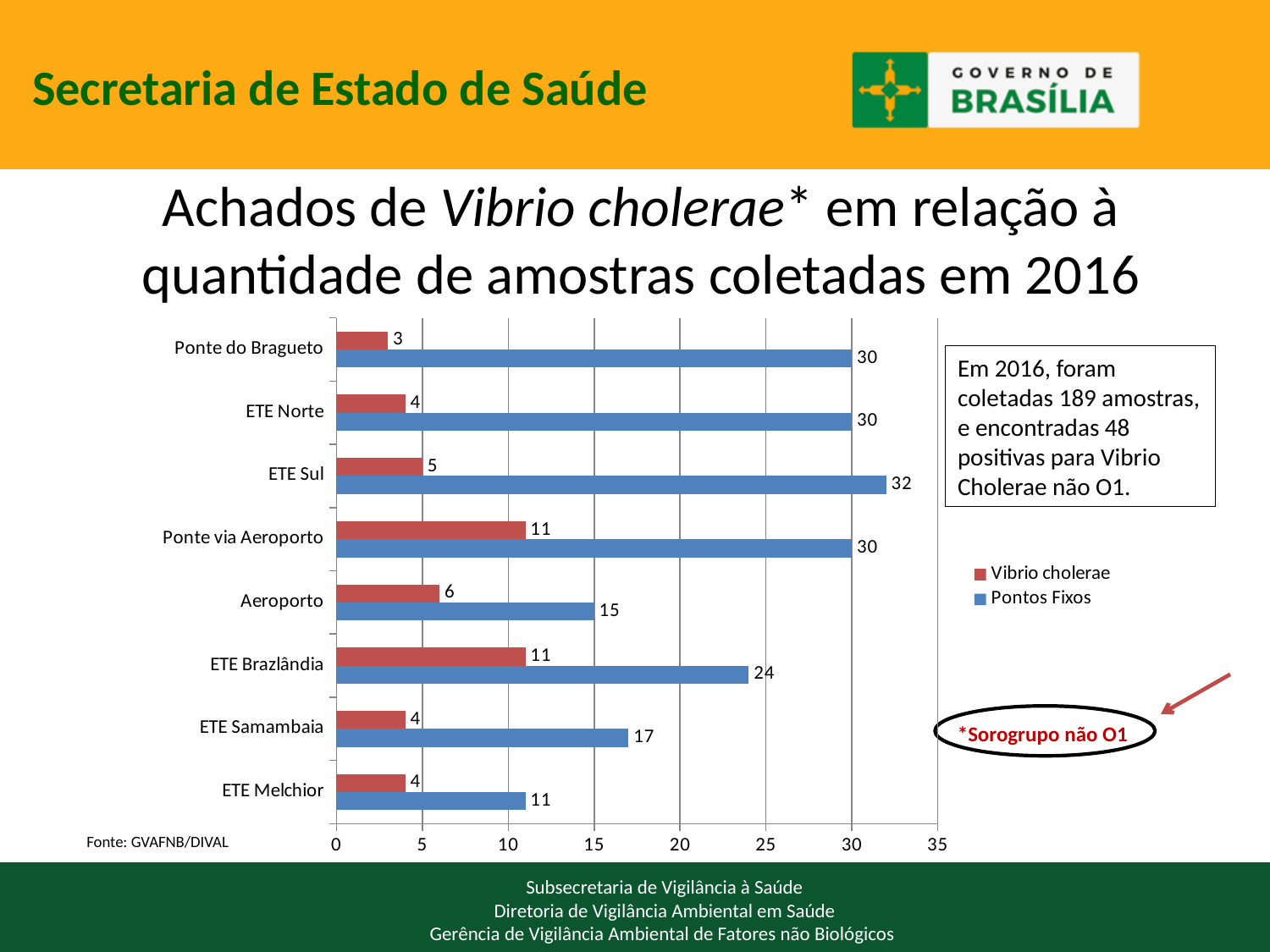
How many series does the legend list? 2 Which is larger, the Pontos Fixos value for ETE Brazlândia or for ETE Samambaia? ETE Brazlândia What kind of chart is shown on the slide? Bar chart Which category has the lowest Vibrio cholerae value? Ponte do Bragueto What is the Pontos Fixos value for ETE Sul? 32 Which category has the highest Pontos Fixos value? ETE Sul Which category has the lowest Pontos Fixos value? ETE Melchior How many categories are shown on the chart? 8 What is the difference between the Pontos Fixos and Vibrio cholerae values for Aeroporto? 9 Which colour represents the Vibrio cholerae series? Red What is the Vibrio cholerae value for Ponte via Aeroporto? 11 What is the Pontos Fixos value for ETE Melchior? 11